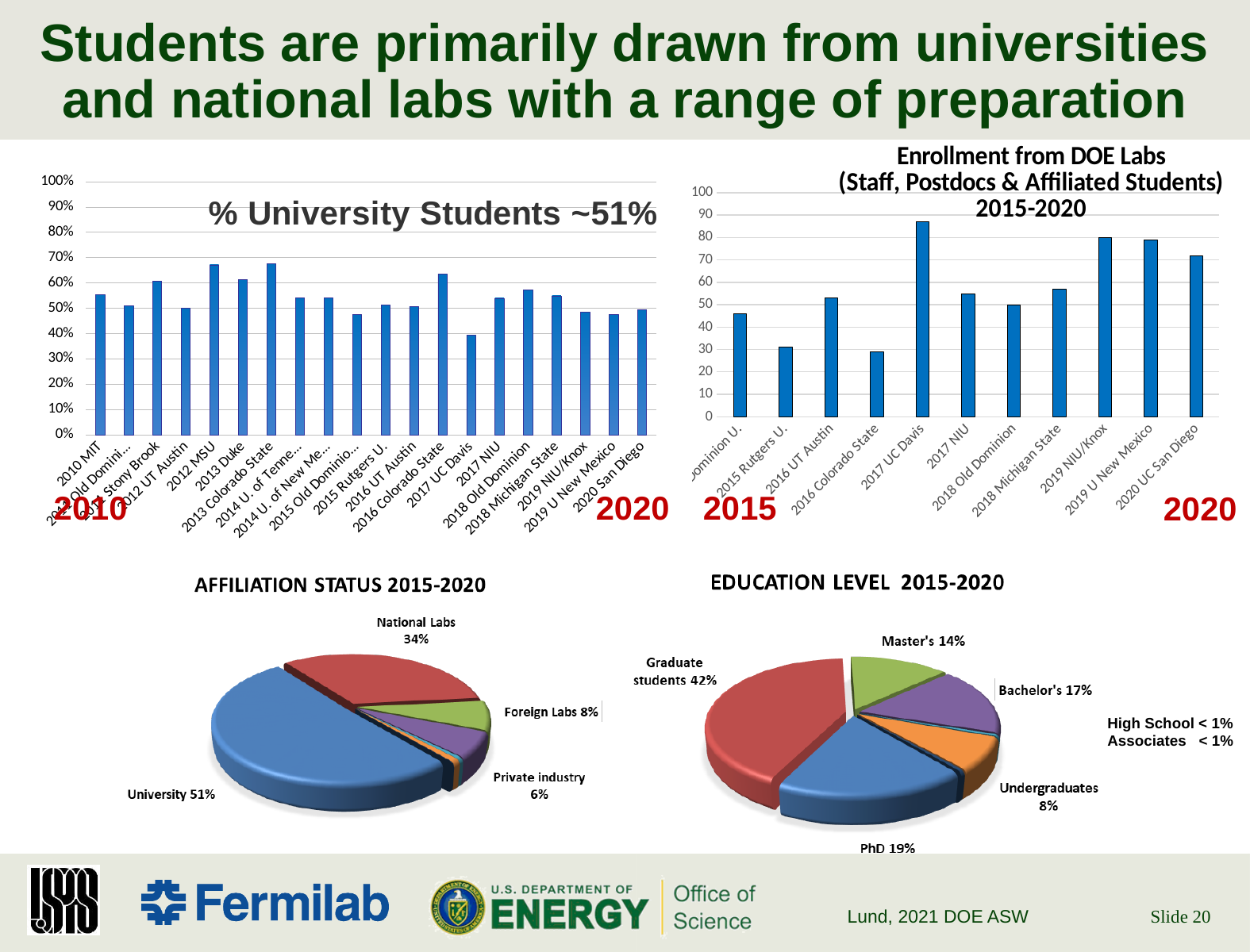
In the Education Level 2015-2020 pie chart, which category has the largest share? Graduate students In the Education Level 2015-2020 pie chart, what share is PhD? 19% In the Education Level 2015-2020 pie chart, which is larger, Bachelor's or Master's? Bachelor's In the Enrollment from DOE Labs chart at the top right, which category has the highest value? 2017 UC Davis In the Enrollment from DOE Labs chart at the top right, is the value for 2019 NIU/Knox greater or less than 70? greater In the Affiliation Status 2015-2020 pie chart, what is the difference between the University and National Labs shares? 17% In the Affiliation Status 2015-2020 pie chart, what share is University? 51% In the Education Level 2015-2020 pie chart, what is the difference between the Bachelor's and Undergraduates shares? 9% What kind of chart is the % University Students chart at the top left? bar chart In the % University Students chart at the top left, which category has the lowest value? 2017 UC Davis In the Affiliation Status 2015-2020 pie chart, what share is National Labs? 34%